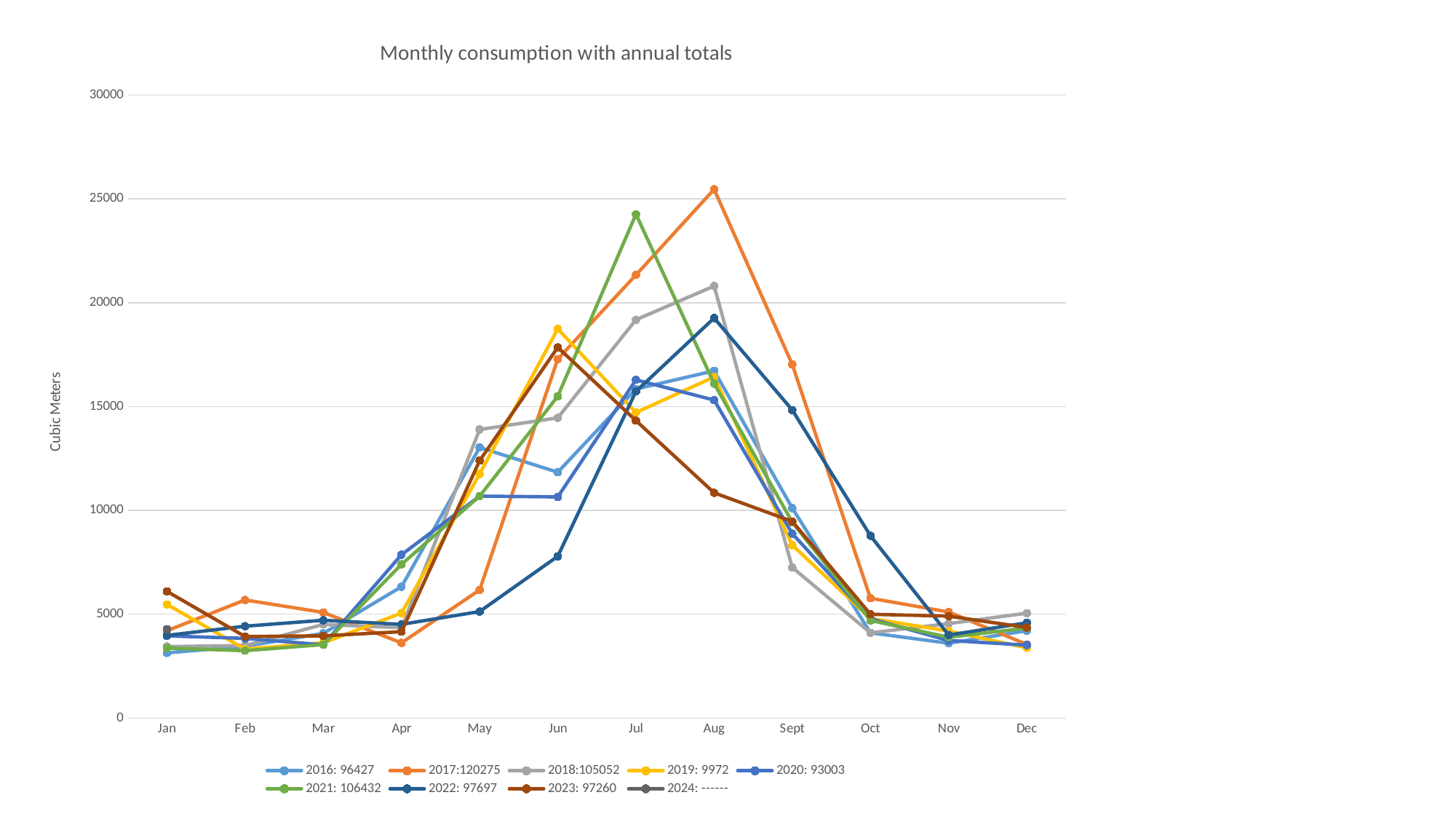
How many months are shown along the x axis? 12 How many series does the legend list? 9 Is the value for 2017 in Aug greater or less than 25000? greater What annual total does the legend show for 2017? 120275 What is the title of the chart? Monthly consumption with annual totals Does the 2017 series rise or fall from Aug to Dec? Fall Is the value for 2022 in Aug greater or less than 20000? less In which month does the 2021 series reach its highest value? Jul In which month does the 2017 series reach its highest value? Aug Which is larger: the 2017 value in Aug or the 2018 value in Aug? 2017 in Aug Is the value for 2017 in Apr greater or less than 5000? less What kind of chart is shown on the slide? Line chart